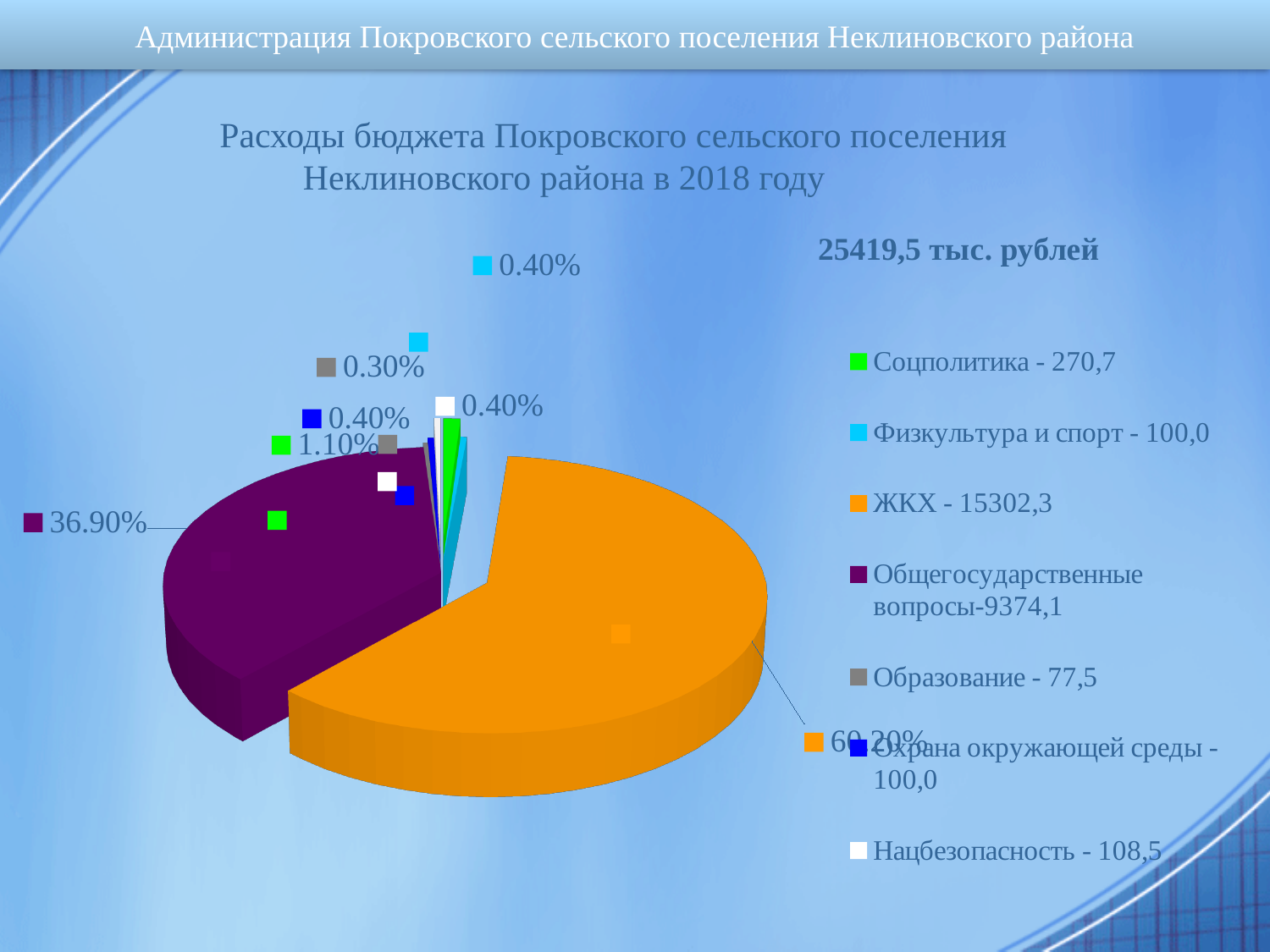
What share of the pie does Соцполитика have? 1.10% What share of the pie does Общегосударственные вопросы have? 36.90% What share of the pie does Образование have? 0.30% What is the difference in percentage points between the shares of Общегосударственные вопросы and Соцполитика? 35.80% What amount is given for Нацбезопасность in the legend? 108,5 What amount is given for ЖКХ in the legend? 15302,3 What total budget expenditure amount is stated on the slide? 25419,5 тыс. рублей How many categories does the legend of the pie chart list? 7 Which category has the smallest slice of the pie? Образование What kind of chart is shown on the slide? pie chart Which has the larger share: Соцполитика or Образование? Соцполитика Which category has the largest slice of the pie? ЖКХ